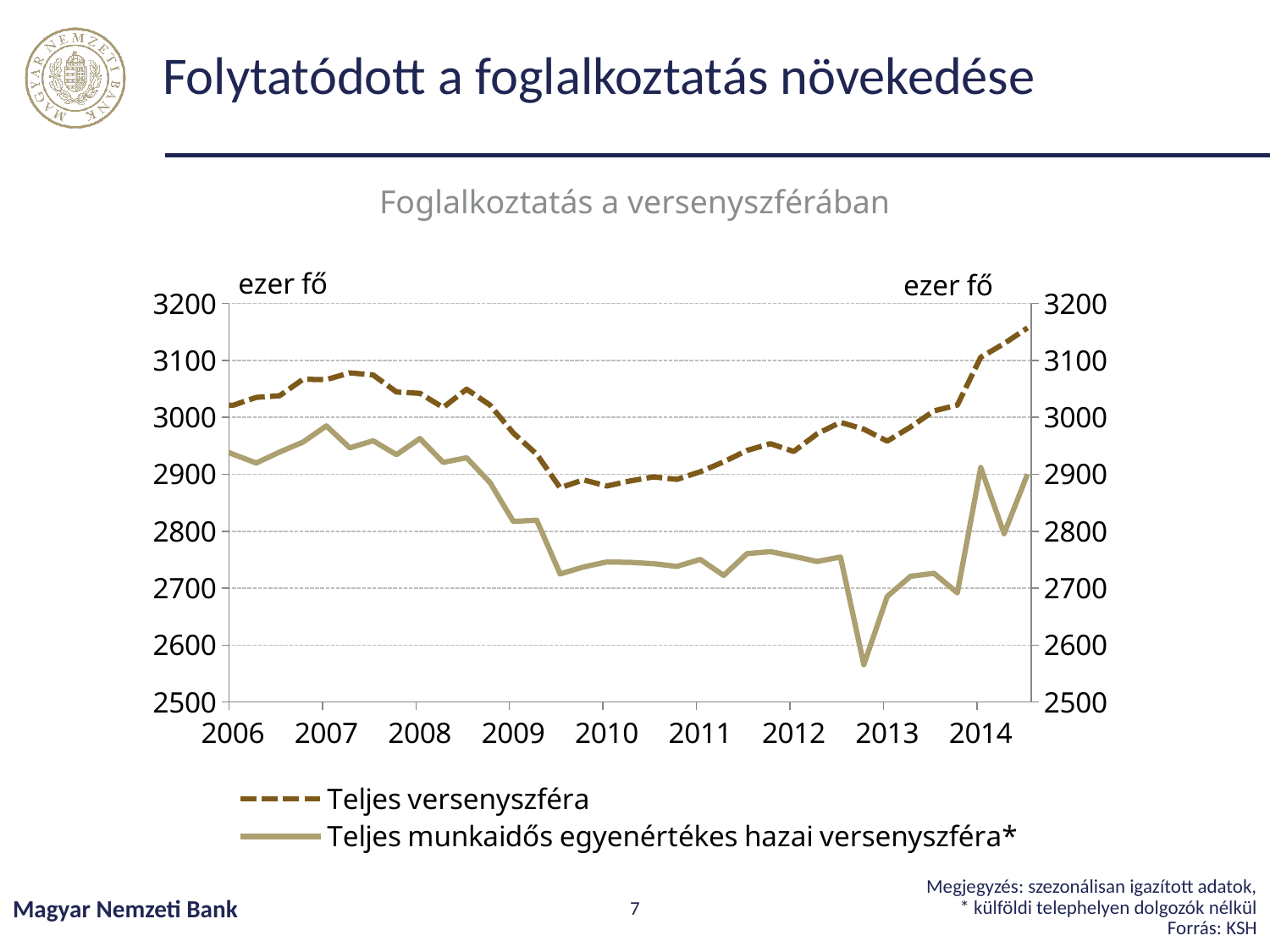
What is the title of the chart? Foglalkoztatás a versenyszférában Does the Teljes versenyszféra series rise or fall between 2008 and 2010? fall How many series does the legend list? 2 Is the lowest point of the Teljes munkaidős egyenértékes hazai versenyszféra* series greater or less than 2600? less Is the value of the Teljes versenyszféra series at the start of 2010 greater or less than 3000? less What kind of chart is shown on the slide? line chart What unit is shown on the vertical axes of the chart? ezer fő In which year does the Teljes versenyszféra series reach its highest value? 2014 How many year labels are shown on the x axis? 9 Is the value of the Teljes versenyszféra series at the start of 2006 greater or less than 2900? greater At the start of 2014, which series has the higher value: Teljes versenyszféra or Teljes munkaidős egyenértékes hazai versenyszféra*? Teljes versenyszféra